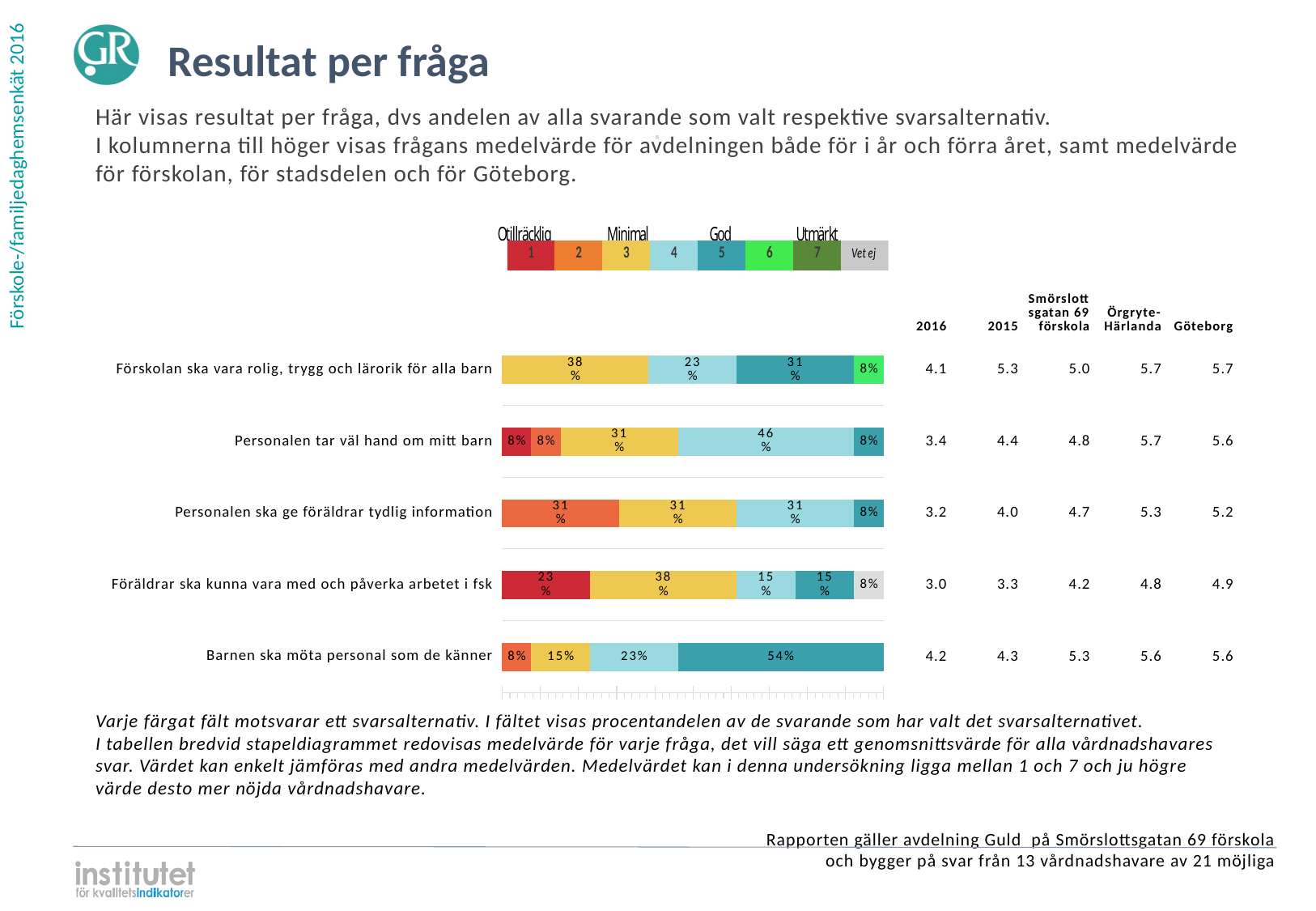
Which question has the largest single segment in its bar? Barnen ska möta personal som de känner What kind of chart is shown on the slide? Stacked bar chart What label appears above legend value 7? Utmärkt How many entries does the legend above the chart list? 8 What percentage chose answer 4 (light blue) for 'Personalen tar väl hand om mitt barn'? 46% What is the 'Vet ej' share for 'Föräldrar ska kunna vara med och påverka arbetet i fsk'? 8% What percentage chose answer 6 (green) for 'Förskolan ska vara rolig, trygg och lärorik för alla barn'? 8% What is the largest segment value in the bar for 'Barnen ska möta personal som de känner'? 54% How many questions (categories) are plotted in the bar chart? 5 In the bar for 'Förskolan ska vara rolig, trygg och lärorik för alla barn', which is larger: the share for answer 3 (yellow) or answer 5 (teal)? Answer 3 (38%) In the bar for 'Barnen ska möta personal som de känner', what is the difference between the 54% segment and the 23% segment? 31 percentage points What percentage chose answer 1 (dark red) for 'Föräldrar ska kunna vara med och påverka arbetet i fsk'? 23%